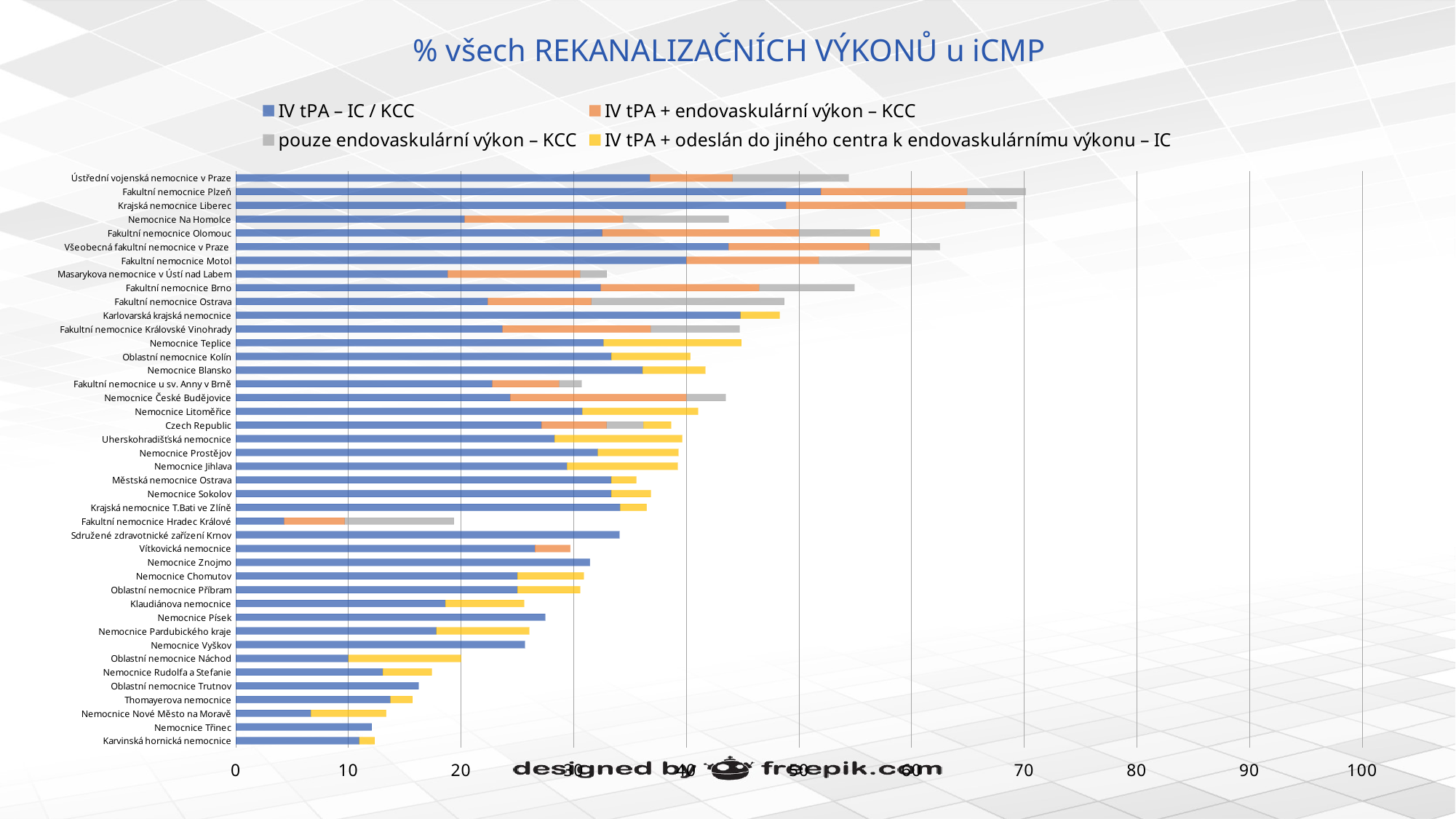
Which has a longer total bar, Fakultní nemocnice Motol or Nemocnice Na Homolce? Fakultní nemocnice Motol Is the total bar length for Karvinská hornická nemocnice greater or less than 20? less What is the title of the chart? % všech REKANALIZAČNÍCH VÝKONŮ u iCMP What kind of chart is shown on the slide? bar chart Is the total bar length for Ústřední vojenská nemocnice v Praze greater or less than 50? greater Is the IV tPA – IC / KCC value for Fakultní nemocnice Hradec Králové greater or less than 10? less Which has a longer total bar, Oblastní nemocnice Náchod or Nemocnice Písek? Nemocnice Písek How many series does the legend list? 4 Which series is shown in yellow in the legend? IV tPA + odeslán do jiného centra k endovaskulárnímu výkonu – IC How many hospitals (categories) are plotted on the chart? 42